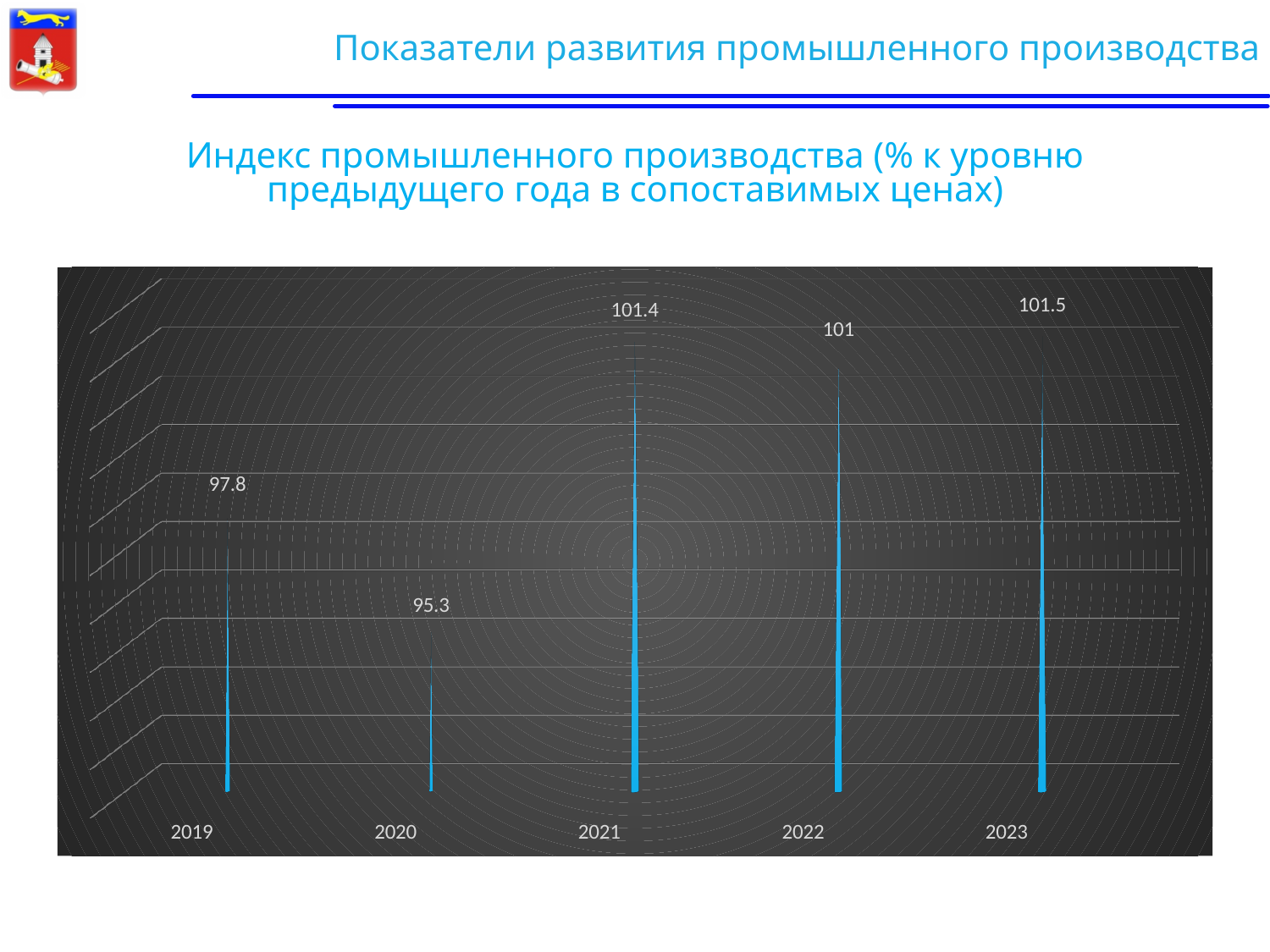
What is the difference between the values for 2021 and 2019? 3.6 Which is larger, the value for 2019 or the value for 2020? 2019 How many years are shown on the x axis? 5 What is the value for 2020? 95.3 What is the value for 2022? 101 Which year has the lowest value? 2020 What is the difference between the values for 2023 and 2020? 6.2 What is the value for 2023? 101.5 What is the value for 2021? 101.4 What is the value for 2019? 97.8 What kind of chart is shown on the slide? bar chart Which year has the highest value? 2023